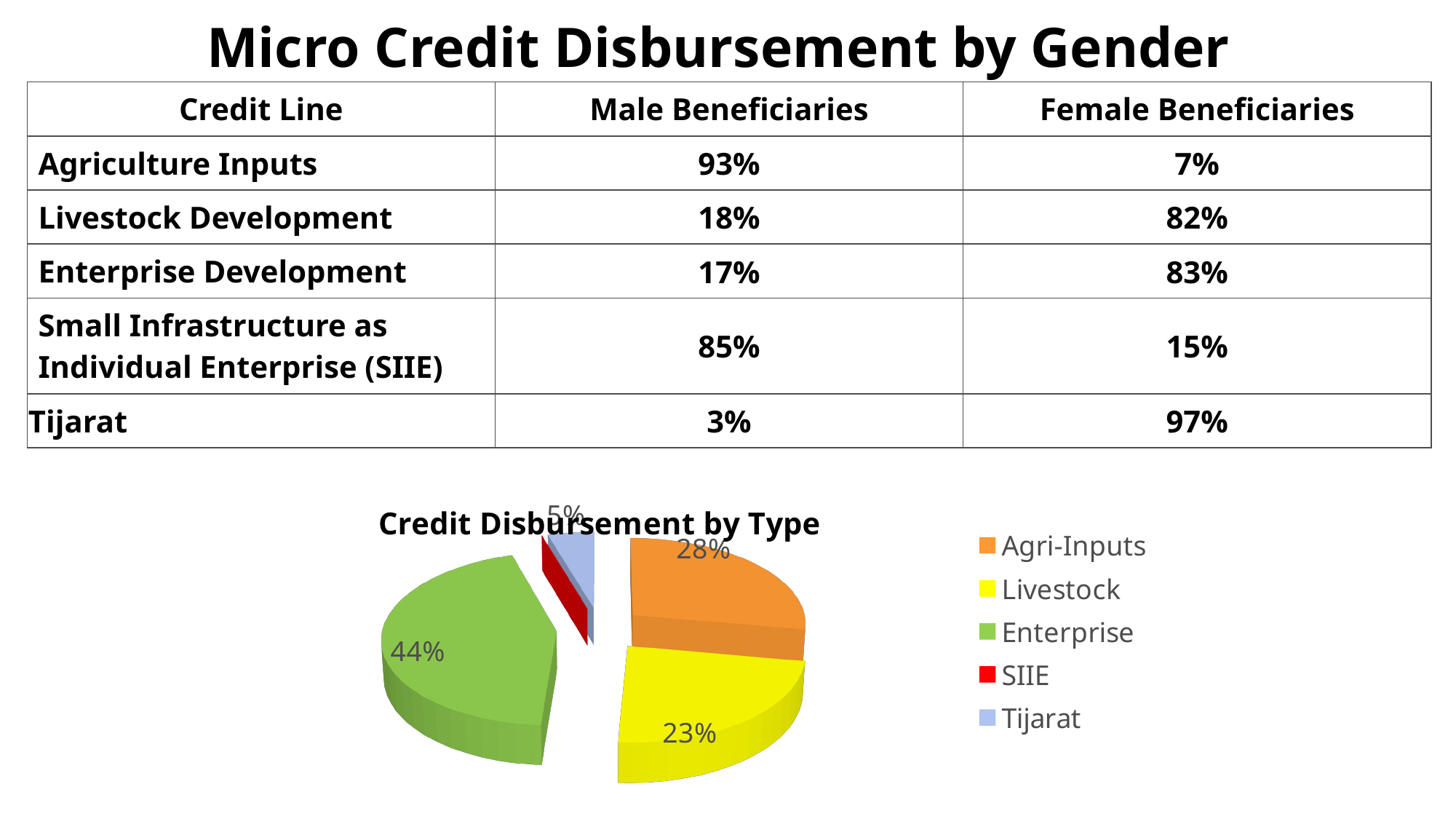
What kind of chart is shown on the slide? Pie chart In the Credit Disbursement by Type chart, what is the difference in percentage points between Agri-Inputs and Livestock? 5 In the Credit Disbursement by Type chart, what share does Enterprise have? 44% In the Credit Disbursement by Type chart, what share does Livestock have? 23% What colour is the Enterprise slice in the Credit Disbursement by Type chart? Green In the Credit Disbursement by Type chart, what share does Agri-Inputs have? 28% In the Credit Disbursement by Type chart, which is larger: Agri-Inputs or Livestock? Agri-Inputs What is the title of the chart on the slide? Credit Disbursement by Type In the Credit Disbursement by Type chart, what is the difference in percentage points between Enterprise and Agri-Inputs? 16 In the Credit Disbursement by Type chart, is the share for Enterprise greater or less than 40%? greater How many categories does the legend of the Credit Disbursement by Type chart list? 5 Which category has the largest slice in the Credit Disbursement by Type chart? Enterprise